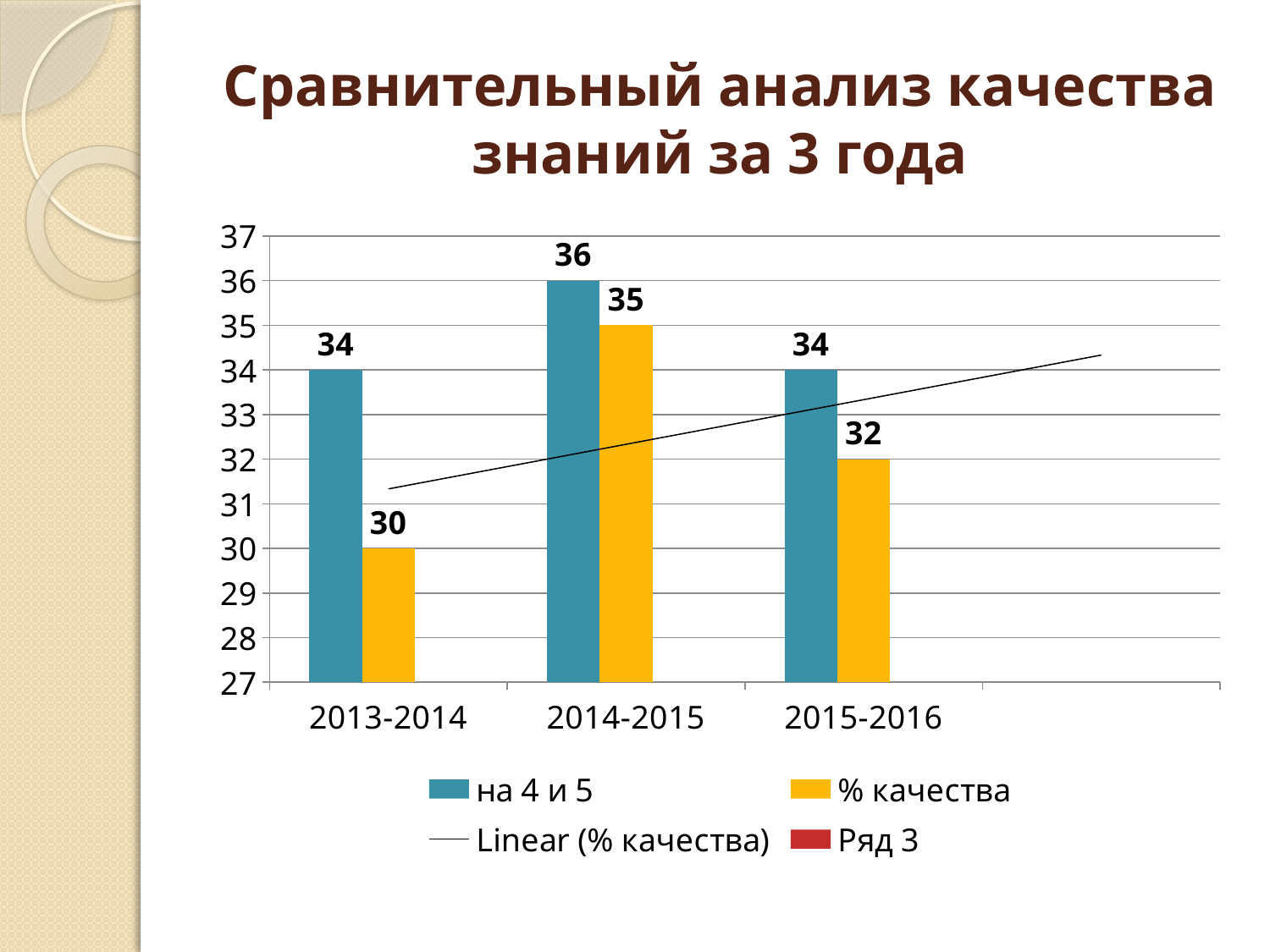
In which year is "% качества" highest? 2014-2015 How many entries does the legend list? 4 How many year categories are shown on the x axis? 3 In which year is "% качества" lowest? 2013-2014 What is the title of the slide? Сравнительный анализ качества знаний за 3 года What is the value of "на 4 и 5" for 2014-2015? 36 What is the value of "% качества" for 2013-2014? 30 Which is larger in 2015-2016: "на 4 и 5" or "% качества"? на 4 и 5 What is the value of "% качества" for 2015-2016? 32 By how much did "% качества" change from 2014-2015 to 2015-2016? 3 What kind of chart is shown on the slide? Bar chart What is the difference between "на 4 и 5" and "% качества" in 2013-2014? 4